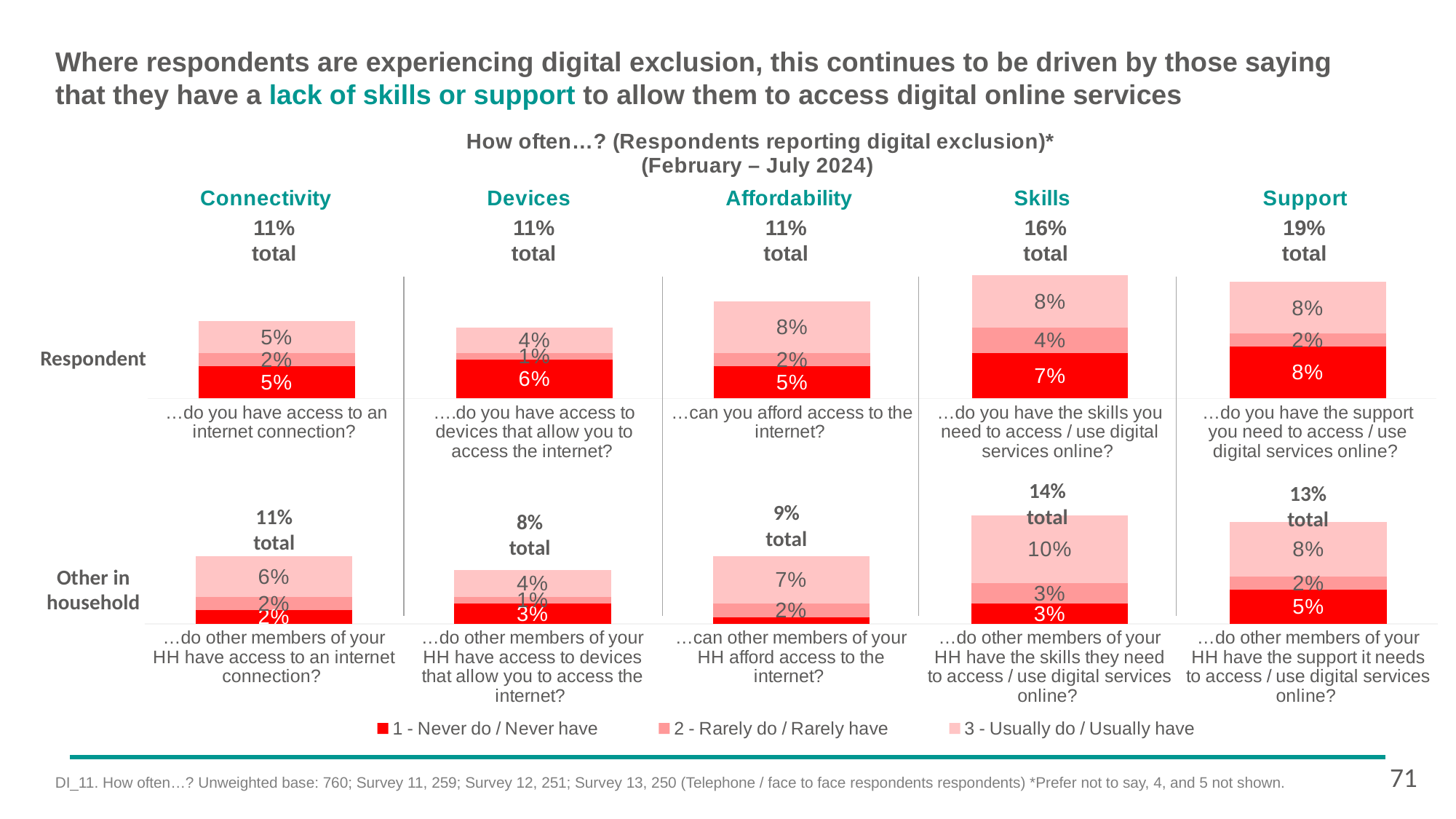
In the Respondent row, what is the difference between the printed totals for Support and Connectivity? 8 percentage points How many series does the legend list? 3 In the Respondent row, which is larger: the '1 - Never do / Never have' value for Devices or for Connectivity? Devices What kind of chart is used on this slide? Stacked bar chart In the Respondent row, what is the value for '3 - Usually do / Usually have' in the Support bar? 8% In the Respondent row, which category has the highest printed total? Support How many categories (Connectivity, Devices, etc.) are shown across the top of the chart? 5 In the Other in household row, which category has the highest printed total? Skills In the Other in household row, what is the value for '1 - Never do / Never have' in the Connectivity bar? 2% In the Respondent row, what is the value for '1 - Never do / Never have' in the Skills bar? 7% In the Other in household row, what is the printed total for Devices? 8% total In the Other in household row, what is the value for '3 - Usually do / Usually have' in the Skills bar? 10%